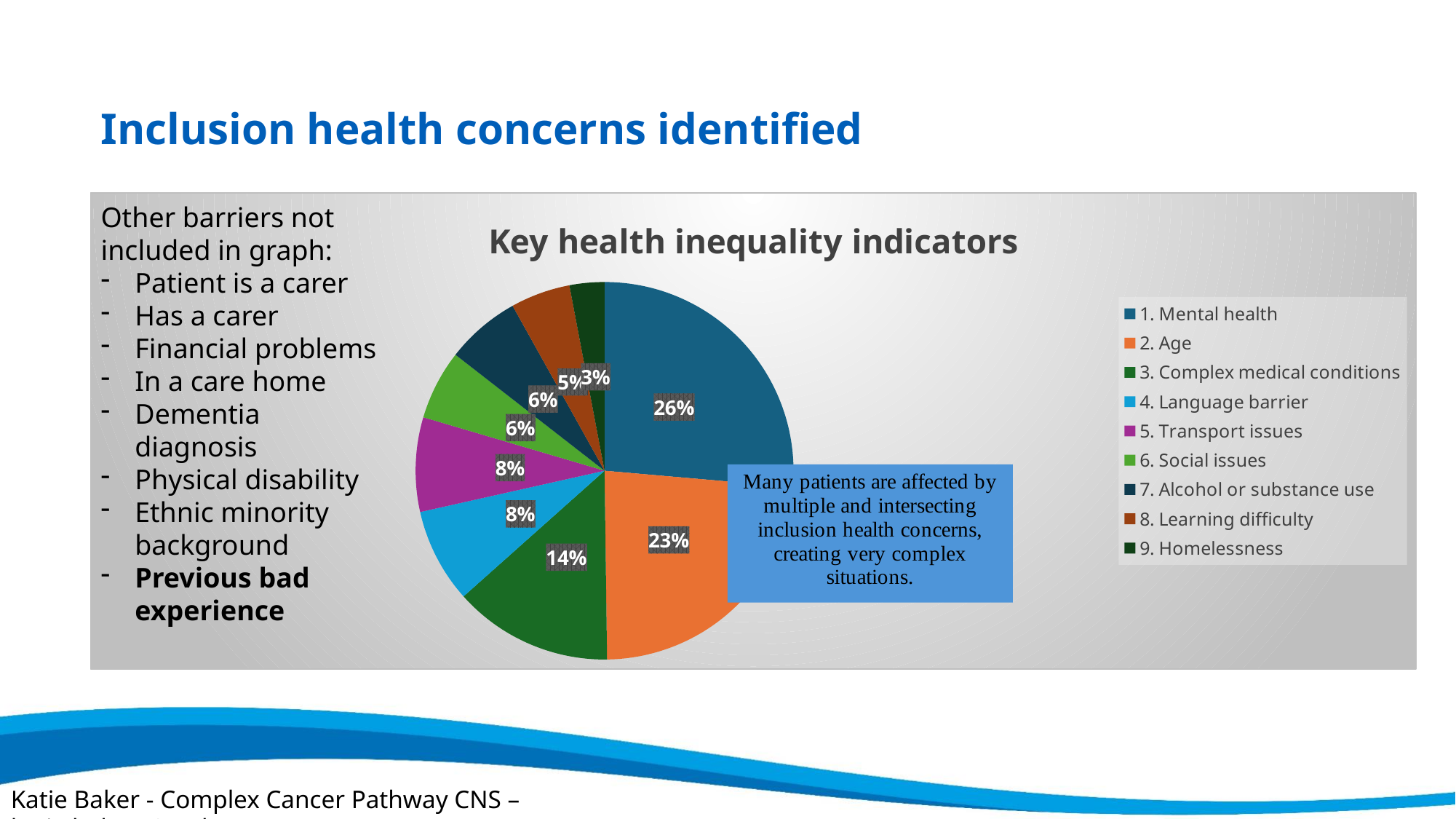
What percentage is shown for Complex medical conditions? 14% What share of the pie does Mental health represent? 26% Which is larger, the slice for Complex medical conditions or the slice for Transport issues? Complex medical conditions What share of the pie does Age represent? 23% How many categories does the legend list? 9 Which category has the smallest slice of the pie? 9. Homelessness What percentage is shown for Homelessness? 3% What percentage is shown for Learning difficulty? 5% What is the title of the chart? Key health inequality indicators What is the difference in percentage points between Mental health and Age? 3 What type of chart is shown on the slide? pie chart Which category has the largest slice of the pie? 1. Mental health